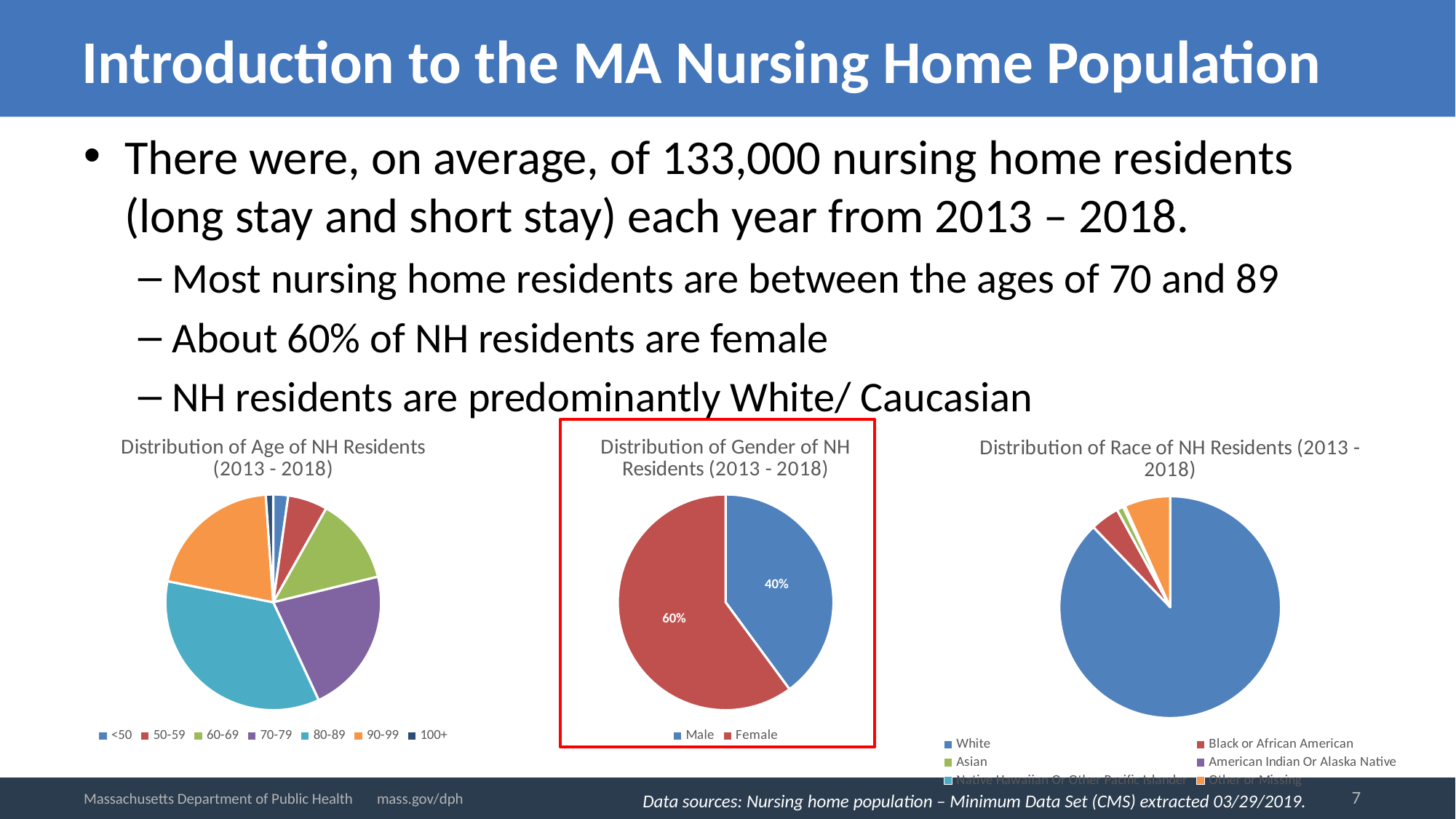
How many age groups does the legend of the 'Distribution of Age of NH Residents (2013 - 2018)' chart list? 7 In the 'Distribution of Gender of NH Residents (2013 - 2018)' chart, what is the difference in percentage points between Female and Male? 20% In the 'Distribution of Gender of NH Residents (2013 - 2018)' chart, what percentage is Male? 40% In the 'Distribution of Gender of NH Residents (2013 - 2018)' chart, which category has the larger share? Female In the 'Distribution of Age of NH Residents (2013 - 2018)' chart, which slice is larger: 60-69 or 90-99? 90-99 In the 'Distribution of Race of NH Residents (2013 - 2018)' chart, which category has the largest slice? White What type of chart is the 'Distribution of Age of NH Residents (2013 - 2018)' chart? Pie chart How many pie charts are shown on the slide? 3 How many categories does the legend of the 'Distribution of Gender of NH Residents (2013 - 2018)' chart list? 2 In the 'Distribution of Age of NH Residents (2013 - 2018)' chart, which age group has the largest slice? 80-89 In the 'Distribution of Gender of NH Residents (2013 - 2018)' chart, what percentage is Female? 60% In the 'Distribution of Age of NH Residents (2013 - 2018)' chart, which slice is larger: 70-79 or 80-89? 80-89